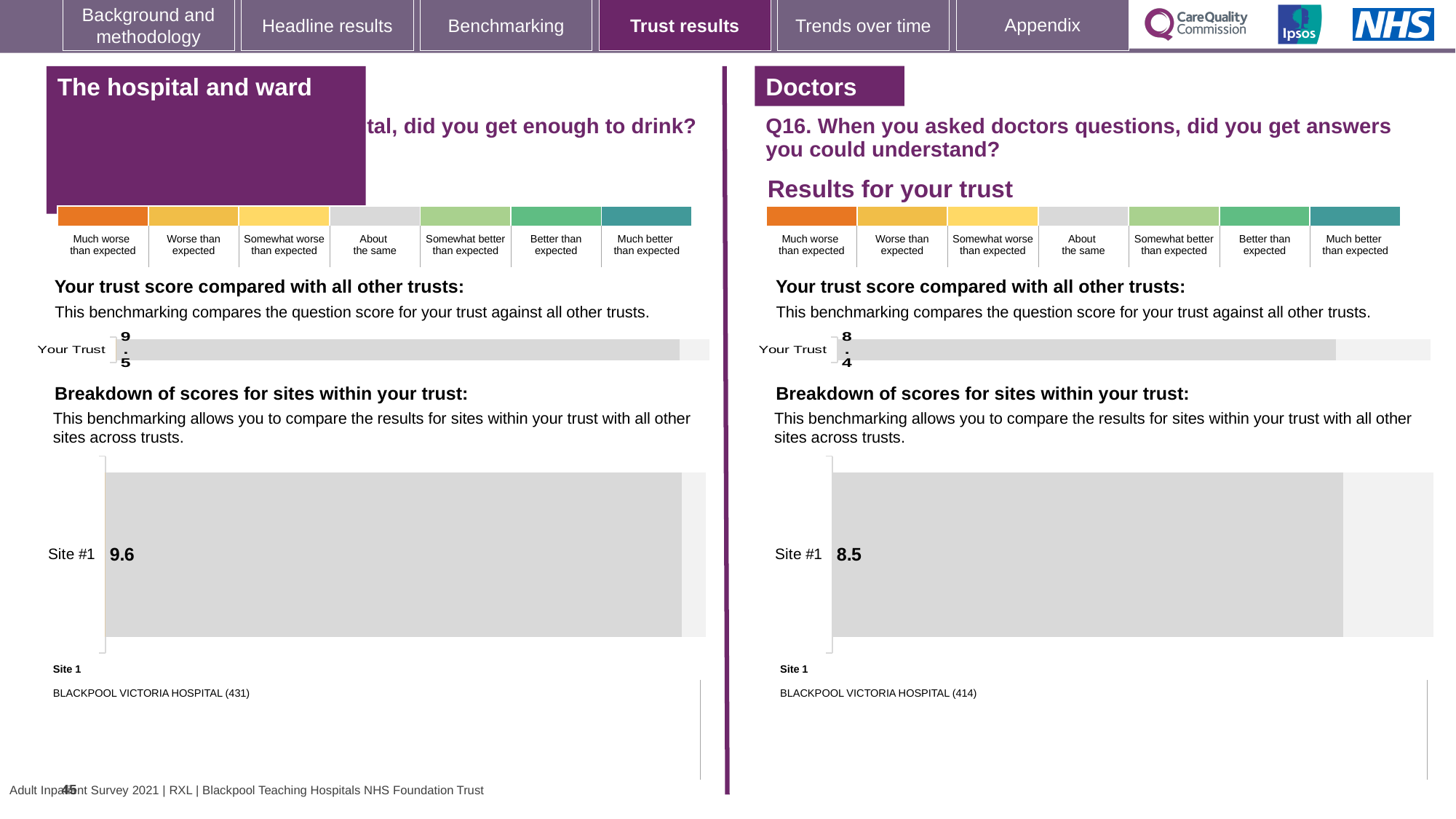
Which hospital is listed as Site 1 beneath the Q16 breakdown chart on the right? BLACKPOOL VICTORIA HOSPITAL Which Site #1 score is higher: the one in the left-hand chart or the one in the Q16 chart on the right? The left-hand chart (9.6) What type of chart is used to show the Site #1 score in the left-hand breakdown chart? Bar chart In the Q16 breakdown of scores for sites chart on the right, what is the score for Site #1? 8.5 Which Your Trust score is higher: the one in the left-hand chart or the one in the Q16 chart on the right? The left-hand chart (9.5) In the Q16 'Doctors' chart on the right, what is the score shown for Your Trust? 8.4 What number appears in parentheses after the Site 1 hospital name beneath the Q16 chart on the right? 414 In the left-hand breakdown of scores for sites chart, what is the score for Site #1? 9.6 In the left-hand section, what is the difference between the Site #1 score and the Your Trust score? 0.1 In the Q16 section on the right, what is the difference between the Site #1 score and the Your Trust score? 0.1 How many sites are shown in the Q16 breakdown of scores for sites chart on the right? 1 In the 'The hospital and ward' chart on the left, what is the score shown for Your Trust? 9.5